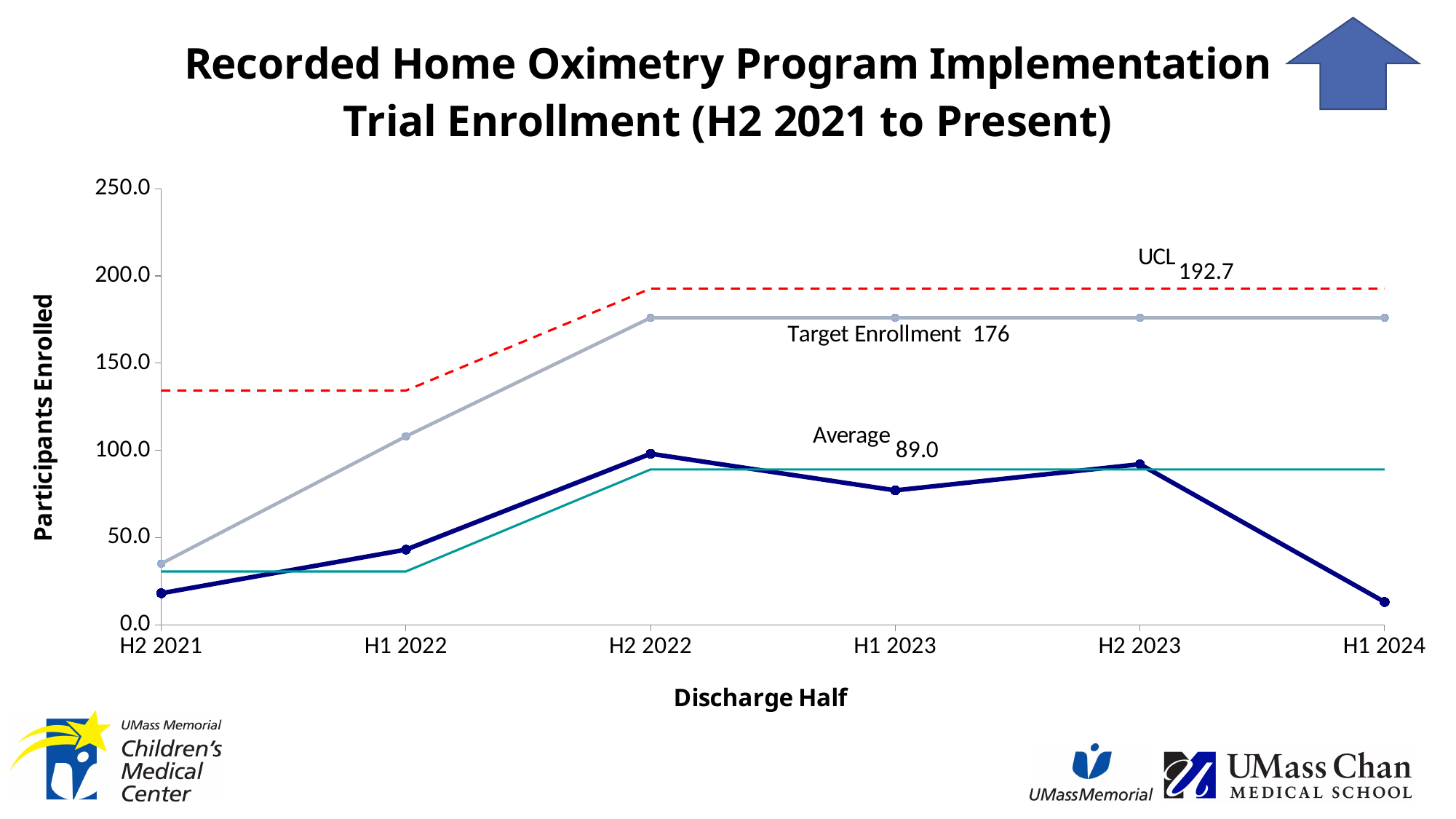
What is the Target Enrollment value shown on the chart? 176 Is the number of participants enrolled in H1 2023 greater or less than 50.0? greater What is the title of the x axis? Discharge Half What is the UCL value shown on the chart? 192.7 What kind of chart is shown on the slide? line chart What is the Average value shown on the chart? 89.0 How many discharge halves are plotted along the x axis? 6 What is the difference between the UCL and the Target Enrollment? 16.7 Did participants enrolled rise or fall from H2 2023 to H1 2024? fall In which discharge half was the number of participants enrolled lowest? H1 2024 Is the number of participants enrolled in H1 2022 greater or less than 50.0? less In which discharge half was the number of participants enrolled highest? H2 2022